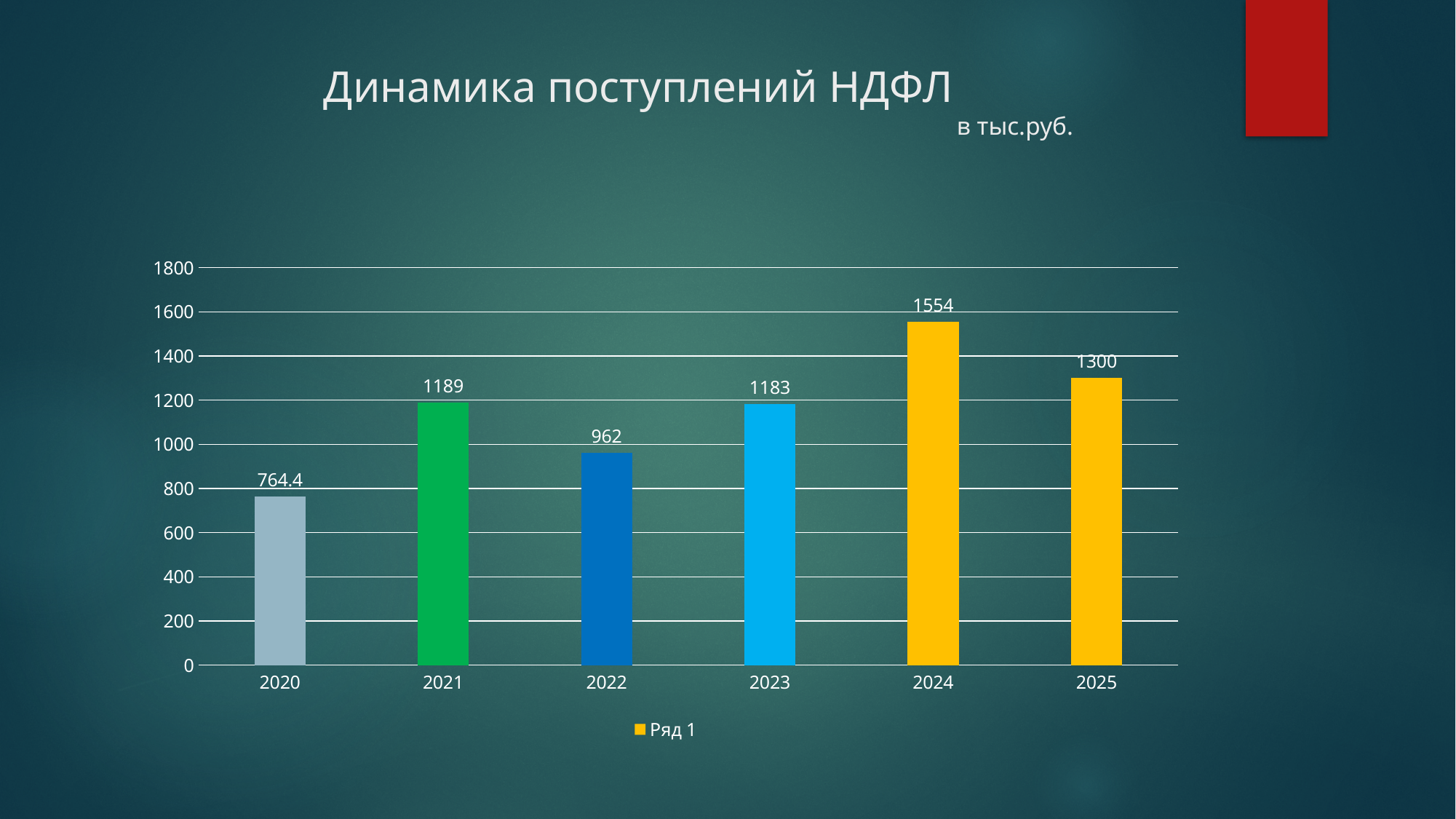
How many series does the legend list? 1 How many years are shown on the x axis? 6 What is the value for 2020? 764.4 Which is larger, the value for 2021 or the value for 2022? 2021 What is the value for 2024? 1554 What is the title of the chart? Динамика поступлений НДФЛ What is the value for 2022? 962 Is the value for 2023 greater or less than 1000? greater What kind of chart is shown? bar chart Which year has the highest value? 2024 What is the difference between the values for 2024 and 2025? 254 Which year has the lowest value? 2020